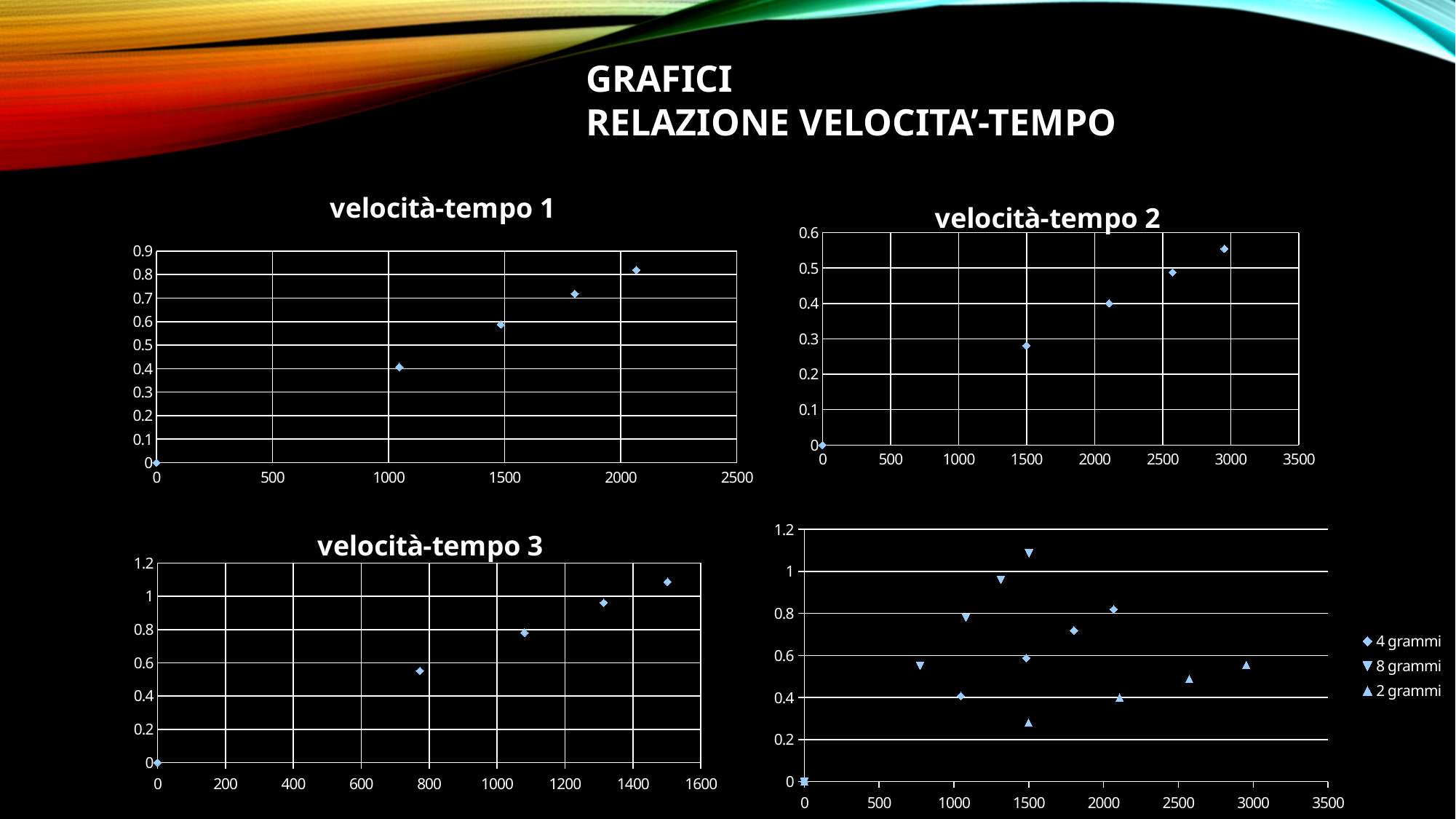
How many data points are plotted in the "velocità-tempo 1" chart? 5 In the "velocità-tempo 2" chart, do the values rise or fall along the x axis? rise In the "velocità-tempo 2" chart, is the value of the point near x=3000 greater or less than 0.5? greater What kind of chart is "velocità-tempo 1"? scatter chart In the "velocità-tempo 3" chart, is the value of the rightmost point (near x=1500) greater or less than 1? greater How many data points are plotted in the "velocità-tempo 2" chart? 5 In the "velocità-tempo 1" chart, do the values rise or fall as time increases along the x axis? rise In the "velocità-tempo 3" chart, do the values rise or fall along the x axis? rise In the "velocità-tempo 1" chart, is the value of the point near x=1500 greater or less than 0.5? greater What are the legend entries of the bottom-right chart? 4 grammi, 8 grammi, 2 grammi How many series does the legend of the bottom-right chart list? 3 In the bottom-right chart, which series has the highest value at around x=1500? 8 grammi